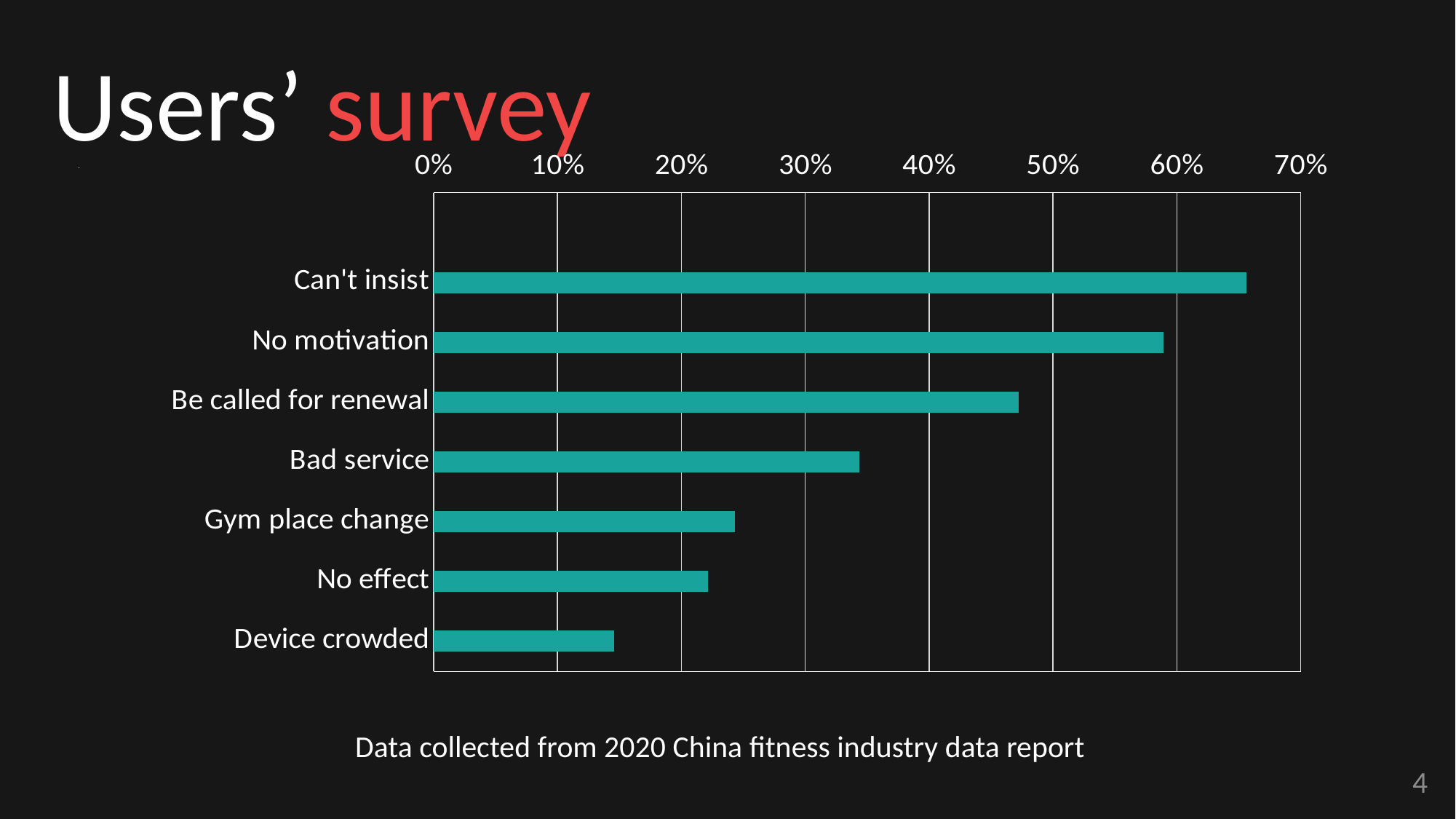
Is the value for Gym place change greater or less than 20%? greater Is the value for Bad service greater or less than 30%? greater Is the value for Be called for renewal greater or less than 50%? less Which category has the lowest value? Device crowded How many categories are plotted in the chart? 7 Which is larger, the value for No motivation or the value for Bad service? No motivation Which category has the highest value? Can't insist According to the note below the chart, where was the data collected from? 2020 China fitness industry data report Do the bar values increase or decrease going from the top category to the bottom category? decrease What kind of chart is shown on the slide? bar chart